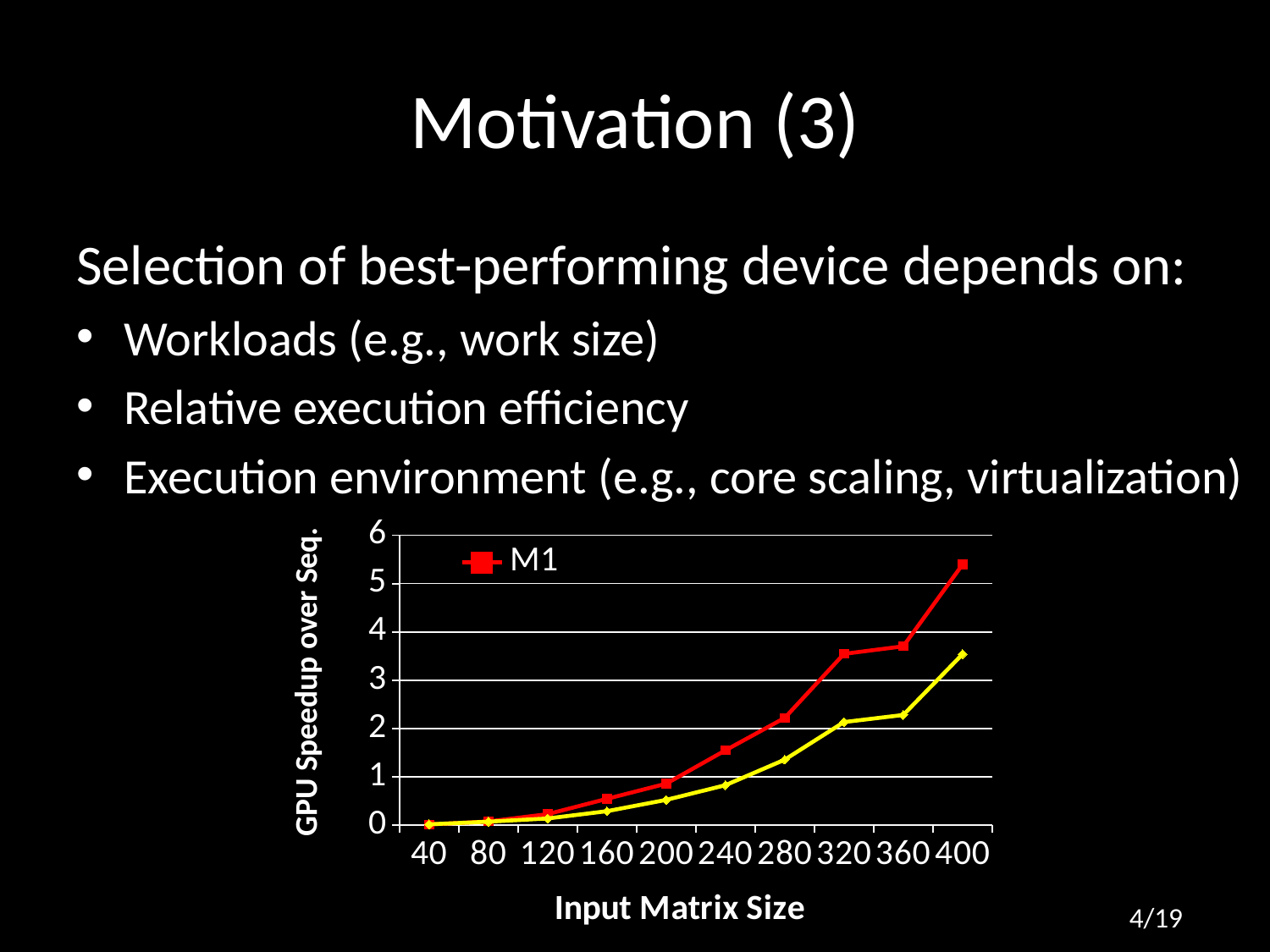
Is the M1 value at input matrix size 400 greater or less than 5? greater At input matrix size 400, which line is higher, the red M1 line or the yellow line? the red M1 line Is the M1 value at input matrix size 320 greater or less than 3? greater At which input matrix size is the M1 series highest? 400 How many input matrix sizes are plotted along the x axis? 10 Is the value of the yellow line at input matrix size 400 greater or less than 4? less What kind of chart is shown on the slide? line chart At which input matrix size is the M1 series lowest? 40 How many series does the legend list? 1 Does the M1 series rise or fall as the input matrix size increases? rises What is the title of the y axis? GPU Speedup over Seq.